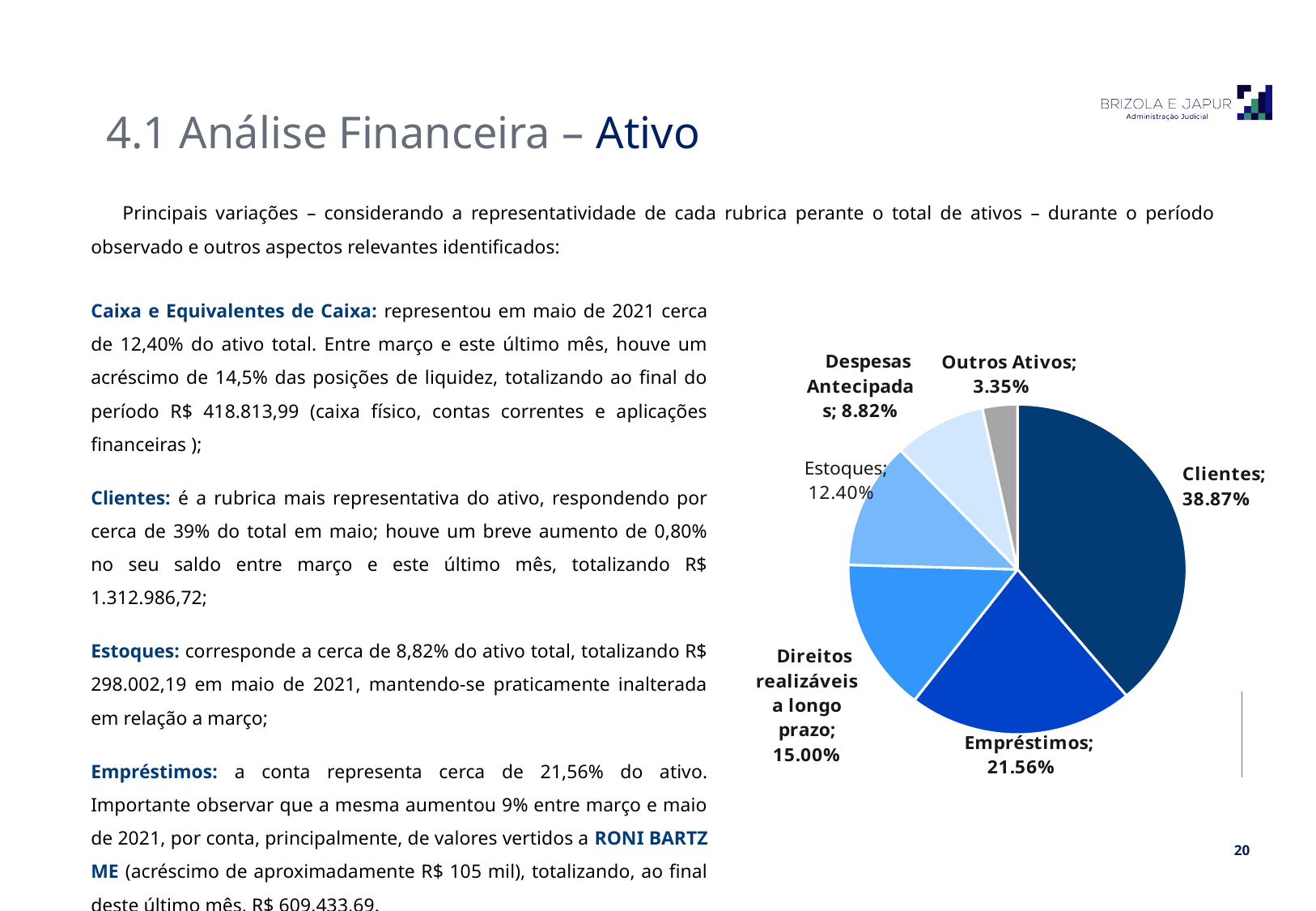
What is the value shown for Empréstimos? 21.56% Which slice of the pie is the largest? Clientes What is the difference between the Clientes share and the Empréstimos share? 17.31% What is the combined share of Estoques and Outros Ativos? 15.75% Which slice of the pie is the smallest? Outros Ativos What is the value shown for Estoques? 12.40% What is the value shown for Direitos realizáveis a longo prazo? 15.00% What kind of chart is shown on the slide? pie chart What is the value shown for Despesas Antecipadas? 8.82% Which is larger, Estoques or Despesas Antecipadas? Estoques How many slices does the pie chart have? 6 What share of the pie does Clientes represent? 38.87%